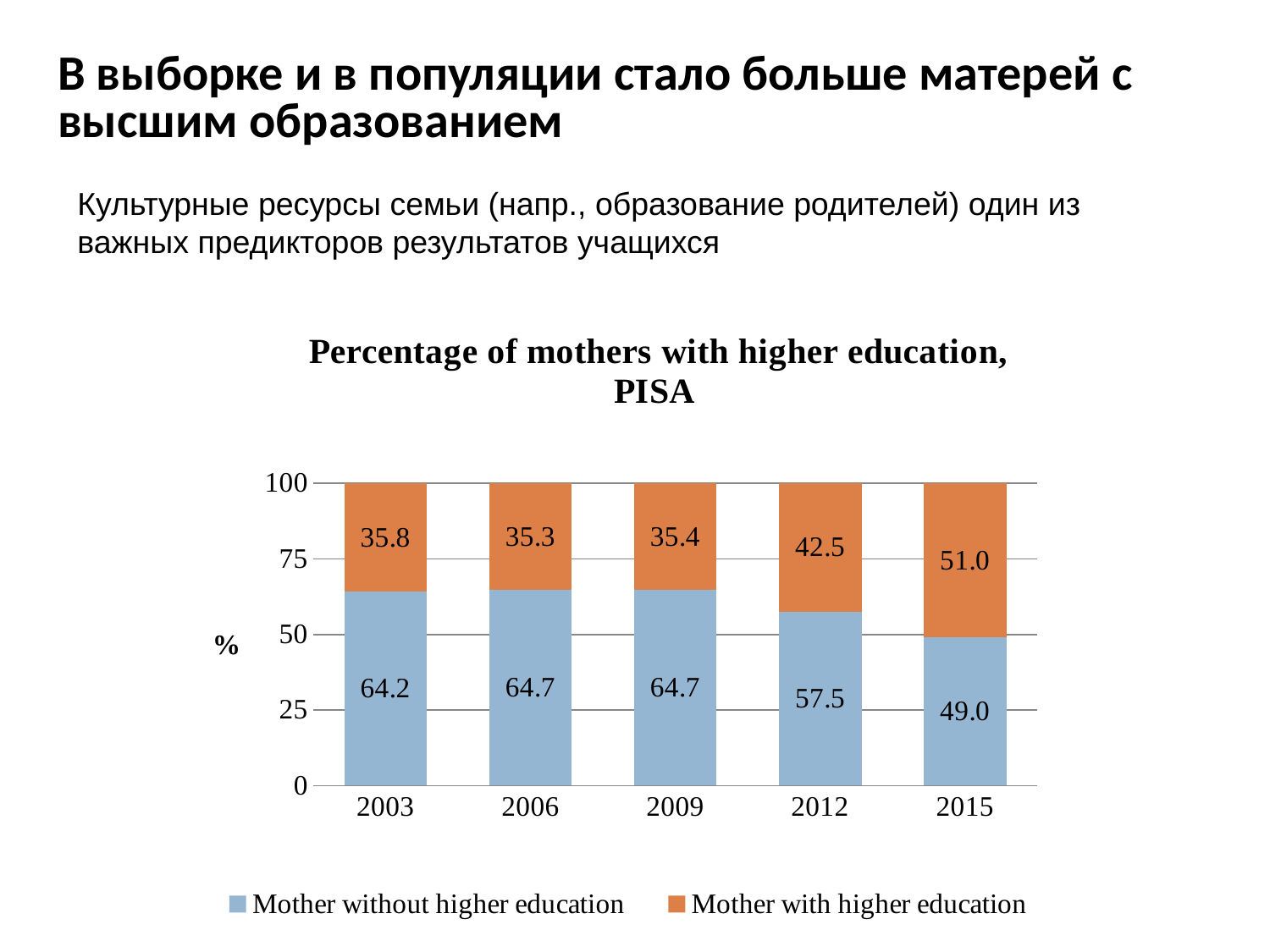
In which year is the value for "Mother with higher education" highest? 2015 What is the value for "Mother with higher education" in 2015? 51.0 In which year is the value for "Mother without higher education" lowest? 2015 Which is larger in 2012: "Mother without higher education" or "Mother with higher education"? Mother without higher education How many years are shown on the x axis? 5 Does the value for "Mother with higher education" rise or fall from 2009 to 2015? Rise What is the value for "Mother without higher education" in 2003? 64.2 What is the difference between the "Mother with higher education" values for 2015 and 2003? 15.2 How many series does the legend list? 2 What is the value for "Mother with higher education" in 2012? 42.5 What kind of chart is shown on the slide? Stacked bar chart What is the title of the chart? Percentage of mothers with higher education, PISA